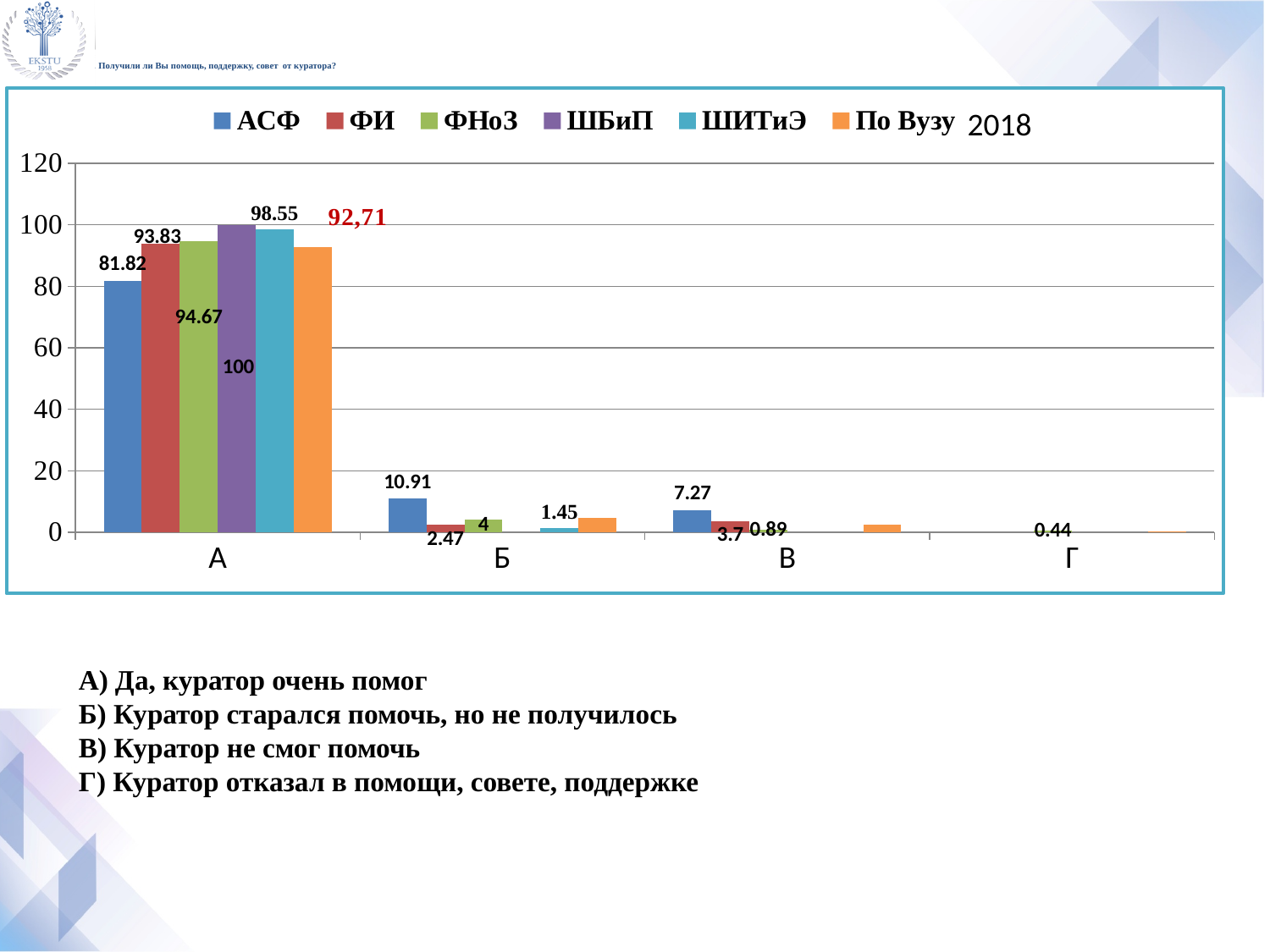
Is the value for По Вузу in category Б greater or less than 20? less What is the value for ШИТиЭ in category А? 98.55 How many categories are shown on the x axis? 4 What is the value for ШБиП in category А? 100 In category А, which series has the highest value? ШБиП In category А, which series has the lowest value? АСФ What is the value for АСФ in category А? 81.82 How many series does the legend list? 6 What is the value for АСФ in category Б? 10.91 Is the АСФ value larger in category Б or in category В? Б What is the difference between the ШБиП and АСФ values in category А? 18.18 What kind of chart is shown on the slide? bar chart